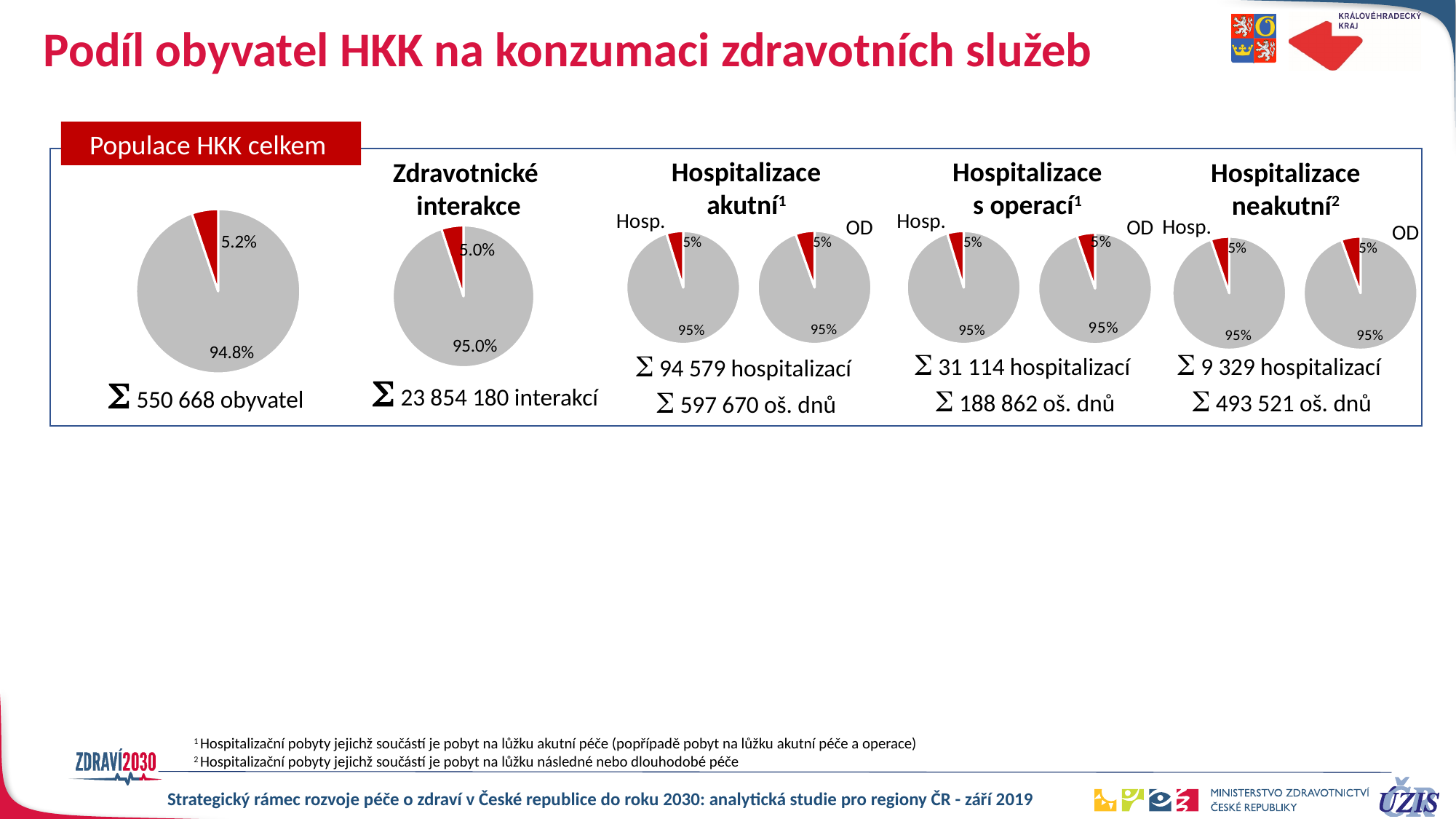
In the 'Hospitalizace neakutní' OD pie chart, what share does the grey slice represent? 95% How many pie charts are shown on the slide in total? 8 In the 'Populace HKK celkem' pie chart, which slice is larger, the red one or the grey one? The grey one What kind of charts are shown on the slide? Pie charts In the 'Populace HKK celkem' pie chart, what share does the red slice represent? 5.2% What total is printed below the 'Populace HKK celkem' pie chart? Σ 550 668 obyvatel In the 'Zdravotnické interakce' pie chart, what share does the grey slice represent? 95.0% In the 'Zdravotnické interakce' pie chart, what share does the red slice represent? 5.0% In the 'Populace HKK celkem' pie chart, what share does the grey slice represent? 94.8% In the 'Populace HKK celkem' pie chart, what is the difference between the grey slice and the red slice? 89.6% In the 'Hospitalizace akutní' Hosp. pie chart, what share does the red slice represent? 5% How many slices does the 'Populace HKK celkem' pie chart have? 2